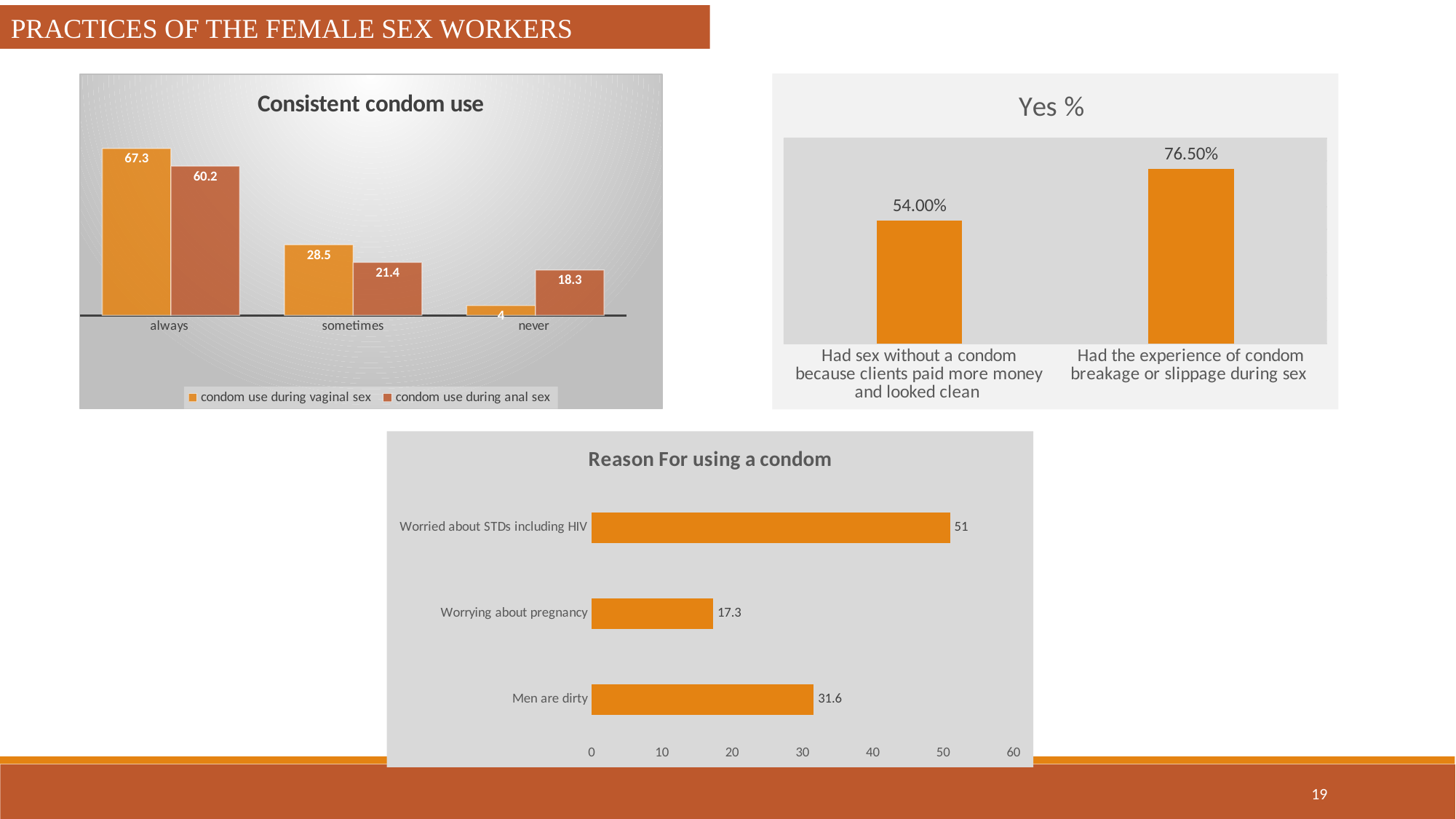
In the 'Consistent condom use' chart, how many series does the legend list? 2 In the 'Reason For using a condom' chart, what is the value for 'Men are dirty'? 31.6 In the 'Consistent condom use' chart, which category has the lowest value for condom use during anal sex? never In the 'Yes %' chart, which of the two categories has the larger value? Had the experience of condom breakage or slippage during sex What kind of chart is the 'Reason For using a condom' chart? bar chart In the 'Consistent condom use' chart, what is the value for condom use during vaginal sex in the 'never' category? 4 In the 'Yes %' chart, how many categories are plotted? 2 In the 'Reason For using a condom' chart, which reason has the highest value? Worried about STDs including HIV In the 'Consistent condom use' chart, what is the difference between condom use during vaginal sex and condom use during anal sex in the 'always' category? 7.1 In the 'Consistent condom use' chart, what is the value for condom use during anal sex in the 'sometimes' category? 21.4 In the 'Yes %' chart, what is the value for 'Had the experience of condom breakage or slippage during sex'? 76.50% In the 'Consistent condom use' chart, what is the value for condom use during vaginal sex in the 'always' category? 67.3